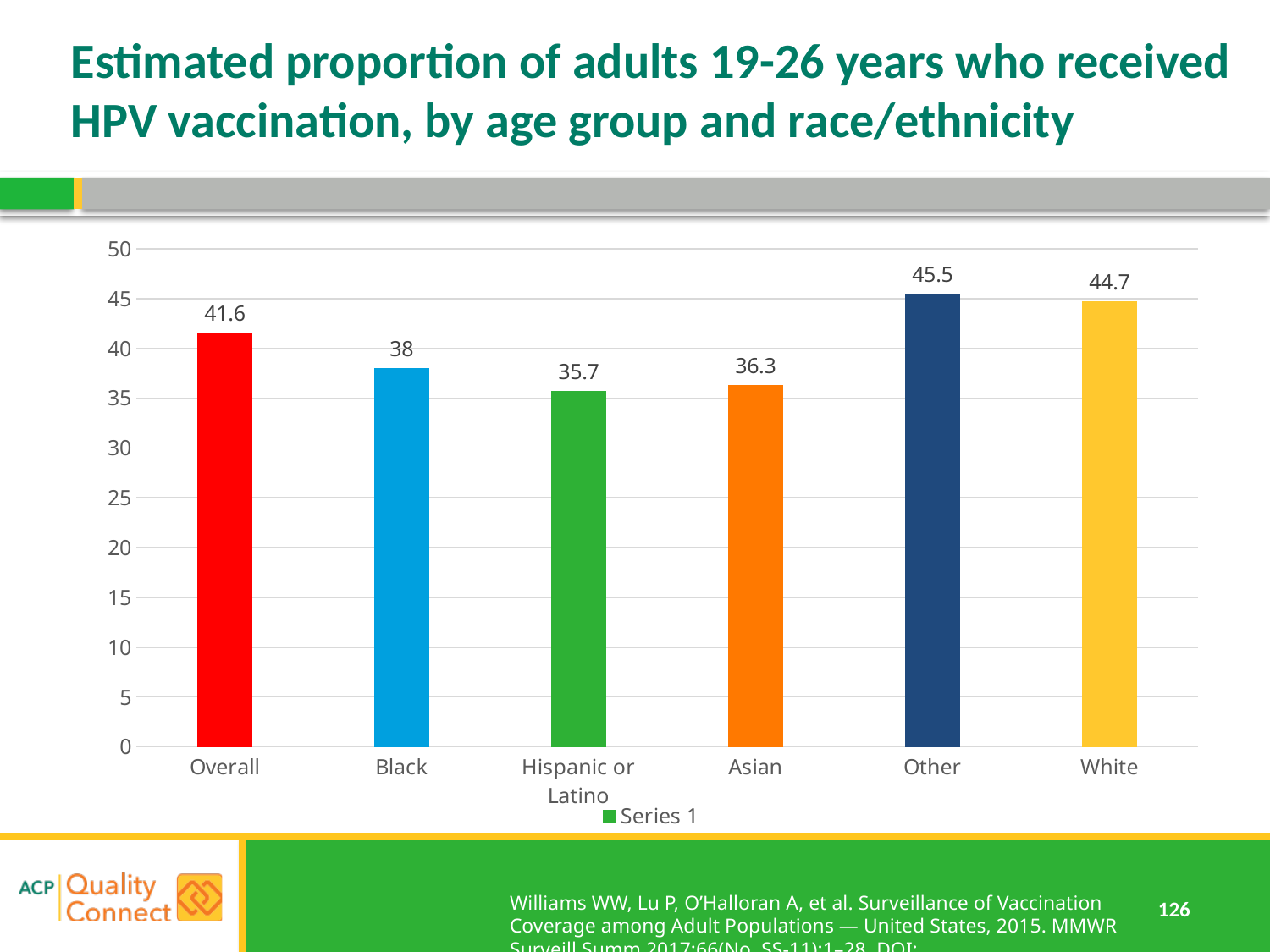
Which category has the lowest value? Hispanic or Latino Which is larger, the value for Black or the value for Asian? Black What is the legend entry shown below the chart? Series 1 Is the value for Asian greater or less than 40? less What is the value for White? 44.7 What is the difference between the values for Other and Black? 7.5 What is the difference between the values for Overall and Asian? 5.3 How many categories are shown on the x axis? 6 What is the value for Hispanic or Latino? 35.7 Which category has the highest value? Other What is the value for Overall? 41.6 What kind of chart is shown on the slide? bar chart